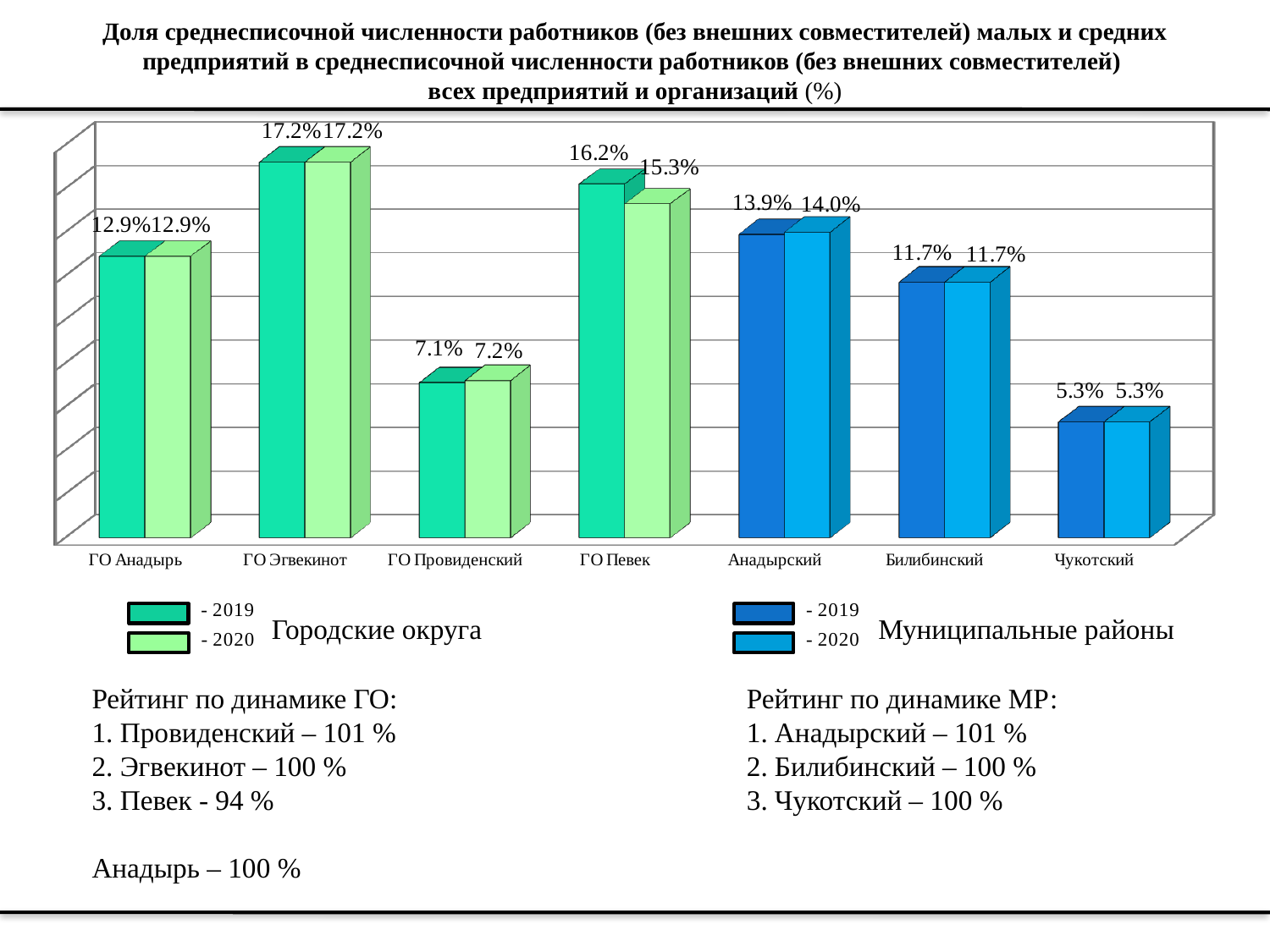
Which category has the highest 2020 value? ГО Эгвекинот What kind of chart is shown on the slide? Bar chart What is the difference between the 2020 values for ГО Эгвекинот and Чукотский? 11.9% Which is larger: the 2020 value for ГО Анадырь or the 2020 value for Анадырский? Анадырский Which category has the lowest 2019 value? Чукотский What is the 2019 value for ГО Певек? 16.2% What is the difference between the 2019 and 2020 values for ГО Певек? 0.9% How many categories are shown on the x axis? 7 What is the 2020 value for Анадырский? 14.0% What is the 2019 value for Билибинский? 11.7% Which colour is used for the bars of the municipal districts (Муниципальные районы)? Blue What is the 2020 value for ГО Провиденский? 7.2%